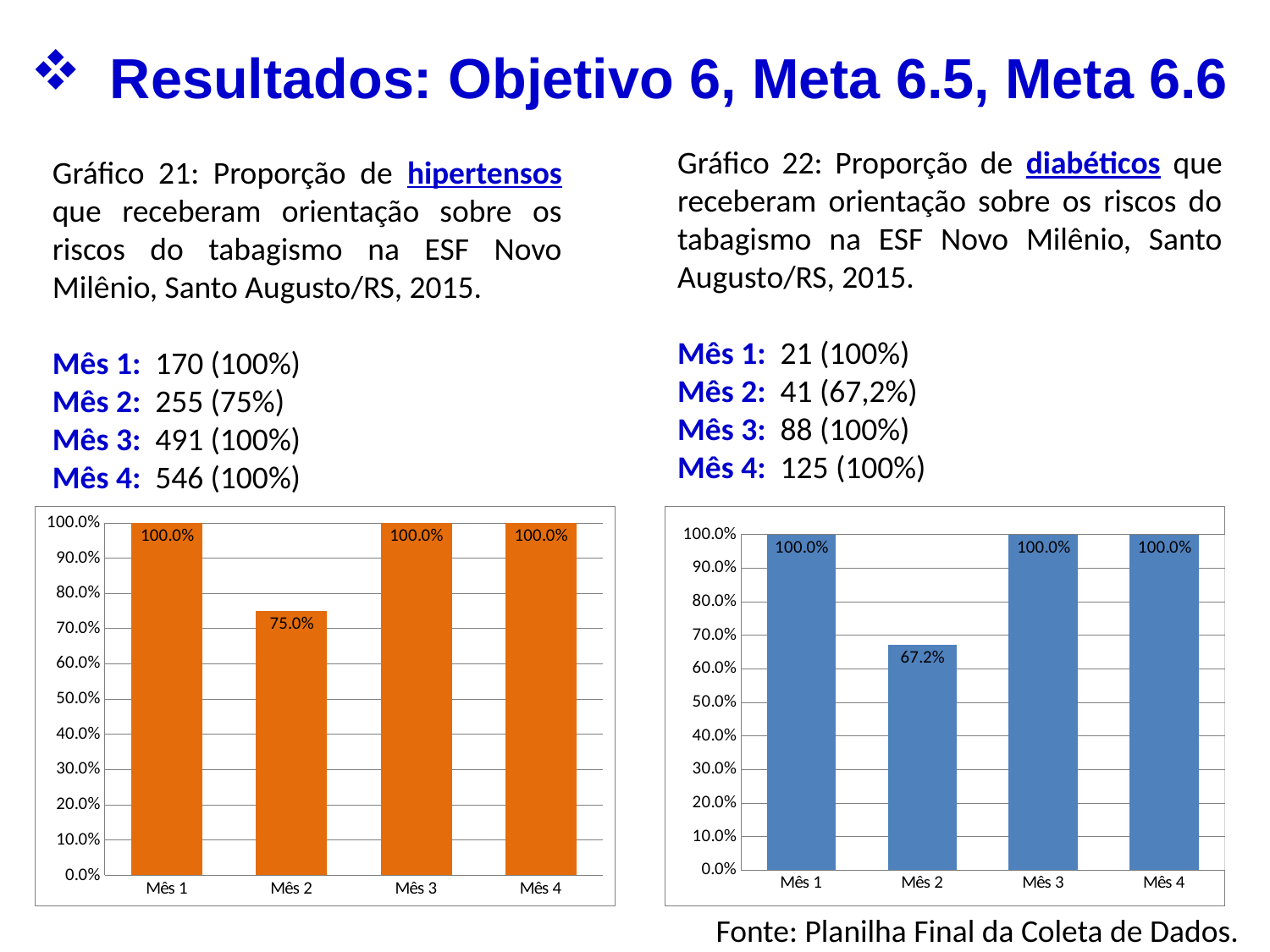
In the left chart (Gráfico 21, hipertensos), what is the difference between the values for Mês 3 and Mês 2? 25.0% In the right chart (Gráfico 22, diabéticos), which month has the lowest value? Mês 2 In the right chart (Gráfico 22, diabéticos), what is the difference between the values for Mês 1 and Mês 2? 32.8% What type of chart is the right chart (Gráfico 22)? Bar chart In the right chart (Gráfico 22, diabéticos), is the value for Mês 2 greater or less than 70.0%? less In the left chart (Gráfico 21, hipertensos), what is the value for Mês 2? 75.0% What colour are the bars in the right chart (Gráfico 22, diabéticos)? Blue How many months (categories) are shown in the left chart (Gráfico 21)? 4 In the left chart (Gráfico 21, hipertensos), what is the value for Mês 4? 100.0% In the right chart (Gráfico 22, diabéticos), what is the value for Mês 2? 67.2% Which is larger: the Mês 2 value in the left chart (Gráfico 21) or the Mês 2 value in the right chart (Gráfico 22)? Left chart (Gráfico 21), 75.0% In the left chart (Gráfico 21, hipertensos), which month has the lowest value? Mês 2